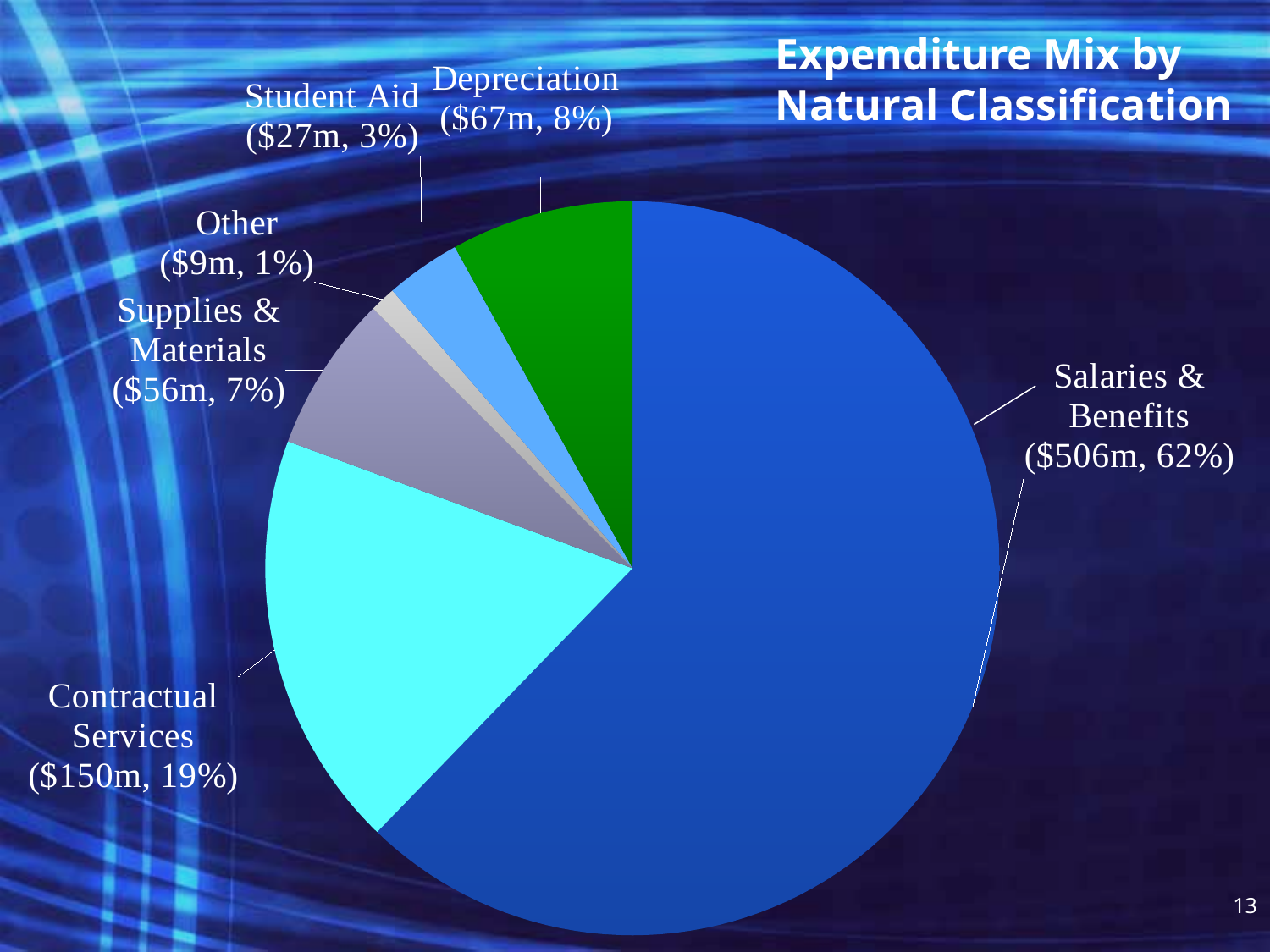
What is the title of the chart? Expenditure Mix by Natural Classification What is the difference in dollars between Contractual Services and Depreciation? $83m What is the dollar amount for Salaries & Benefits? $506m What is the dollar amount for Depreciation? $67m What share of the pie is Supplies & Materials? 7% What is the dollar amount for Student Aid? $27m Which category has the largest slice? Salaries & Benefits Which is larger, Student Aid or Supplies & Materials? Supplies & Materials Which category has the smallest slice? Other How many slices does the pie chart have? 6 What kind of chart is shown on the slide? pie chart What share of the pie is Contractual Services? 19%